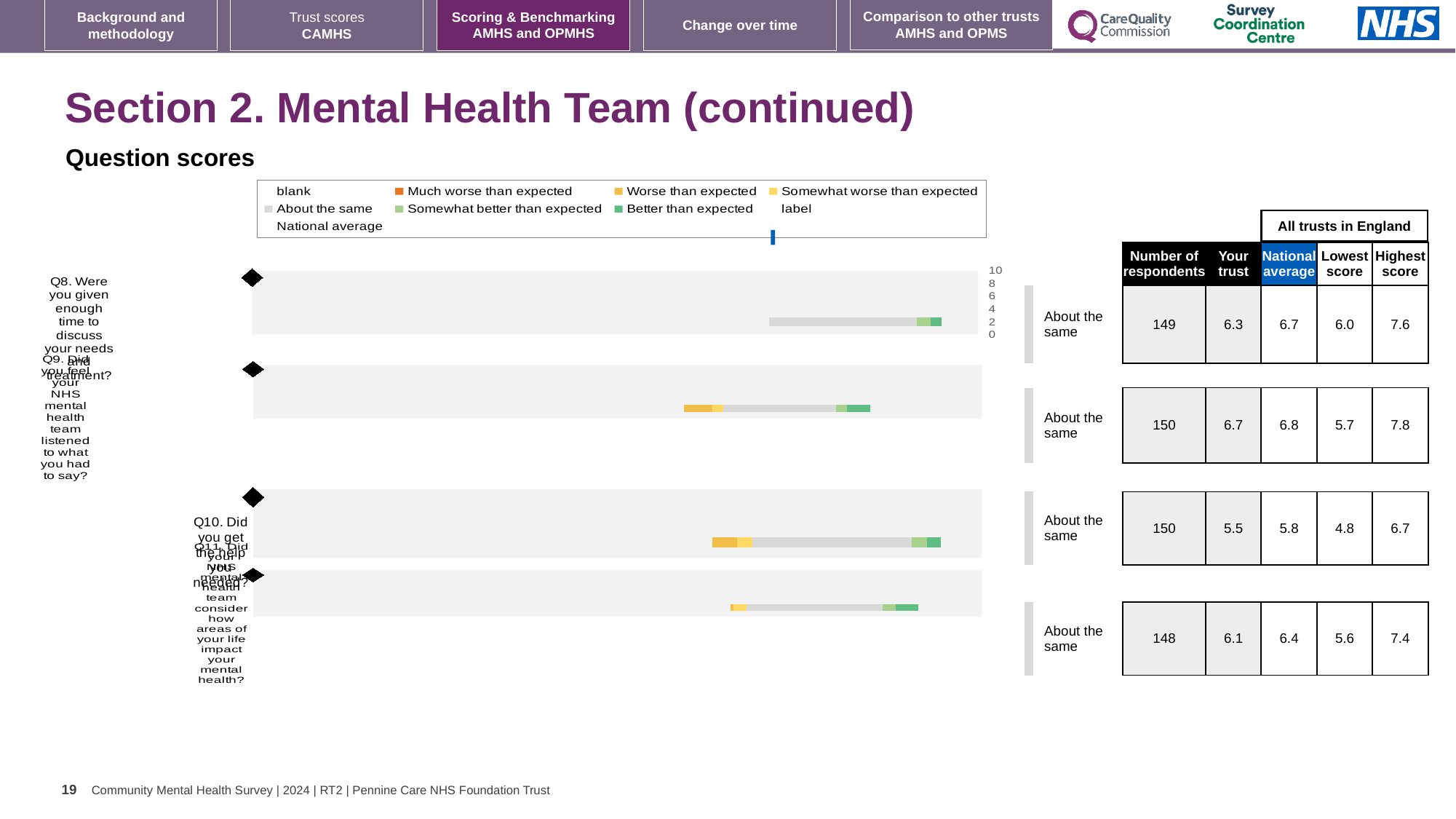
What is the national average score for Q9 (Did you feel your NHS mental health team listened to what you had to say?)? 6.8 How many questions (Q8 to Q11) are plotted on the slide? 4 How many respondents answered Q11? 148 For Q8, which is larger: the trust's score or the national average? National average Which question has the lowest 'Your trust' score? Q10 What is the 'Your trust' score for Q8 (Were you given enough time to discuss your needs and treatment?)? 6.3 What kind of chart is used to show the question scores for Q8 to Q11? bar chart Which question has the highest 'Your trust' score? Q9 What benchmark category is shown for Q10 (Did you get the help you needed?)? About the same What is the lowest score among all trusts in England for Q10? 4.8 What is the highest score among all trusts in England for Q9? 7.8 For Q10, what is the difference between the national average (5.8) and the trust's score (5.5)? 0.3